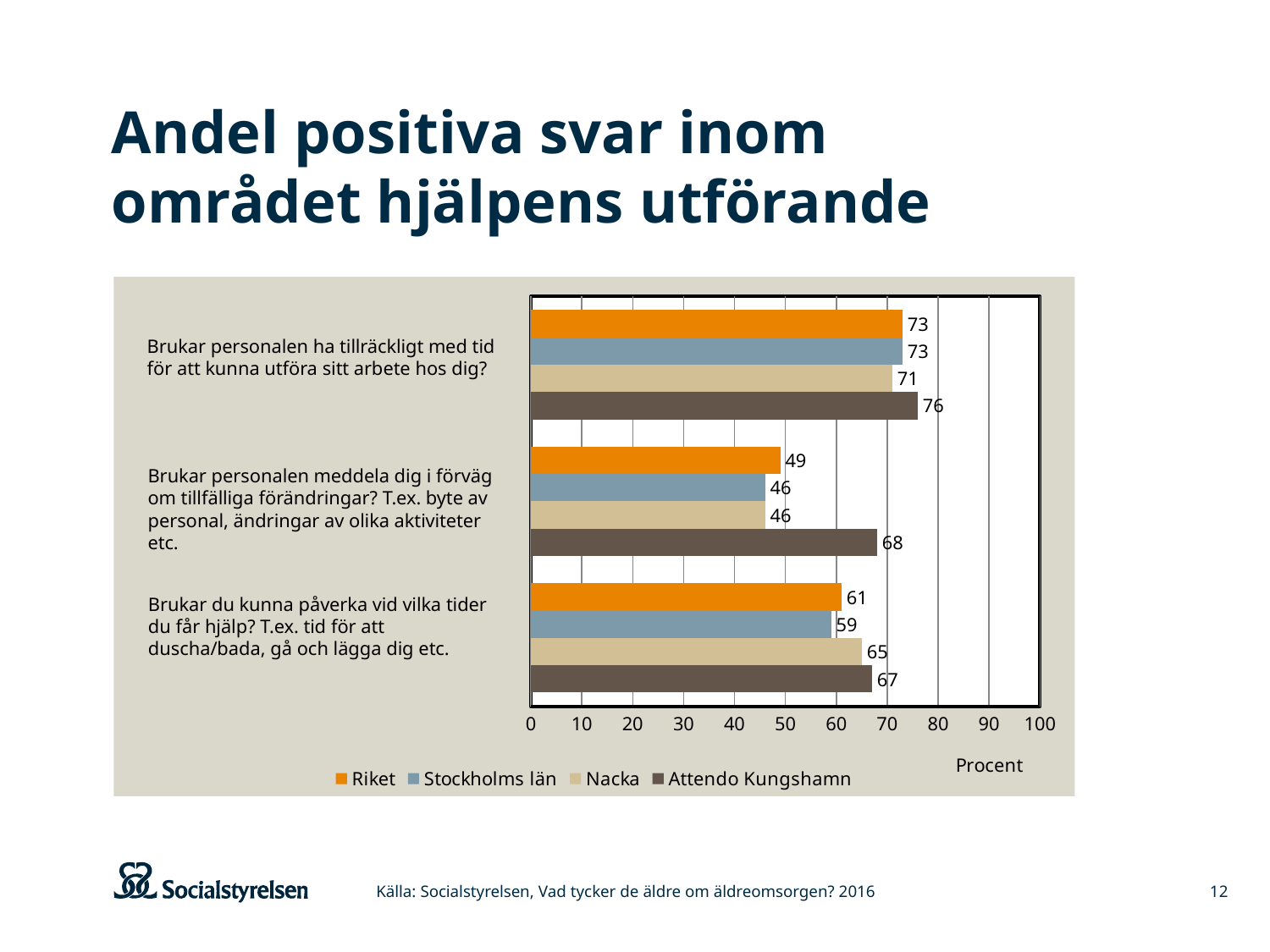
Which is larger on the question "Brukar du kunna påverka vid vilka tider du får hjälp?": Riket or Nacka? Nacka How many questions (categories) are shown on the chart? 3 What is the difference between Attendo Kungshamn and Riket on the question "Brukar personalen meddela dig i förväg om tillfälliga förändringar?"? 19 How many series does the legend list? 4 What is the value for Nacka on the question "Brukar du kunna påverka vid vilka tider du får hjälp?"? 65 What is the difference between Riket and Nacka on the question "Brukar personalen ha tillräckligt med tid för att kunna utföra sitt arbete hos dig?"? 2 What kind of chart is shown on the slide? Bar chart What is the label on the horizontal axis of the chart? Procent Which series has the lowest value on the question "Brukar du kunna påverka vid vilka tider du får hjälp?"? Stockholms län What is the value for Stockholms län on the question "Brukar personalen meddela dig i förväg om tillfälliga förändringar?"? 46 Which series has the highest value on the question "Brukar personalen meddela dig i förväg om tillfälliga förändringar?"? Attendo Kungshamn What is the value for Attendo Kungshamn on the question "Brukar personalen ha tillräckligt med tid för att kunna utföra sitt arbete hos dig?"? 76